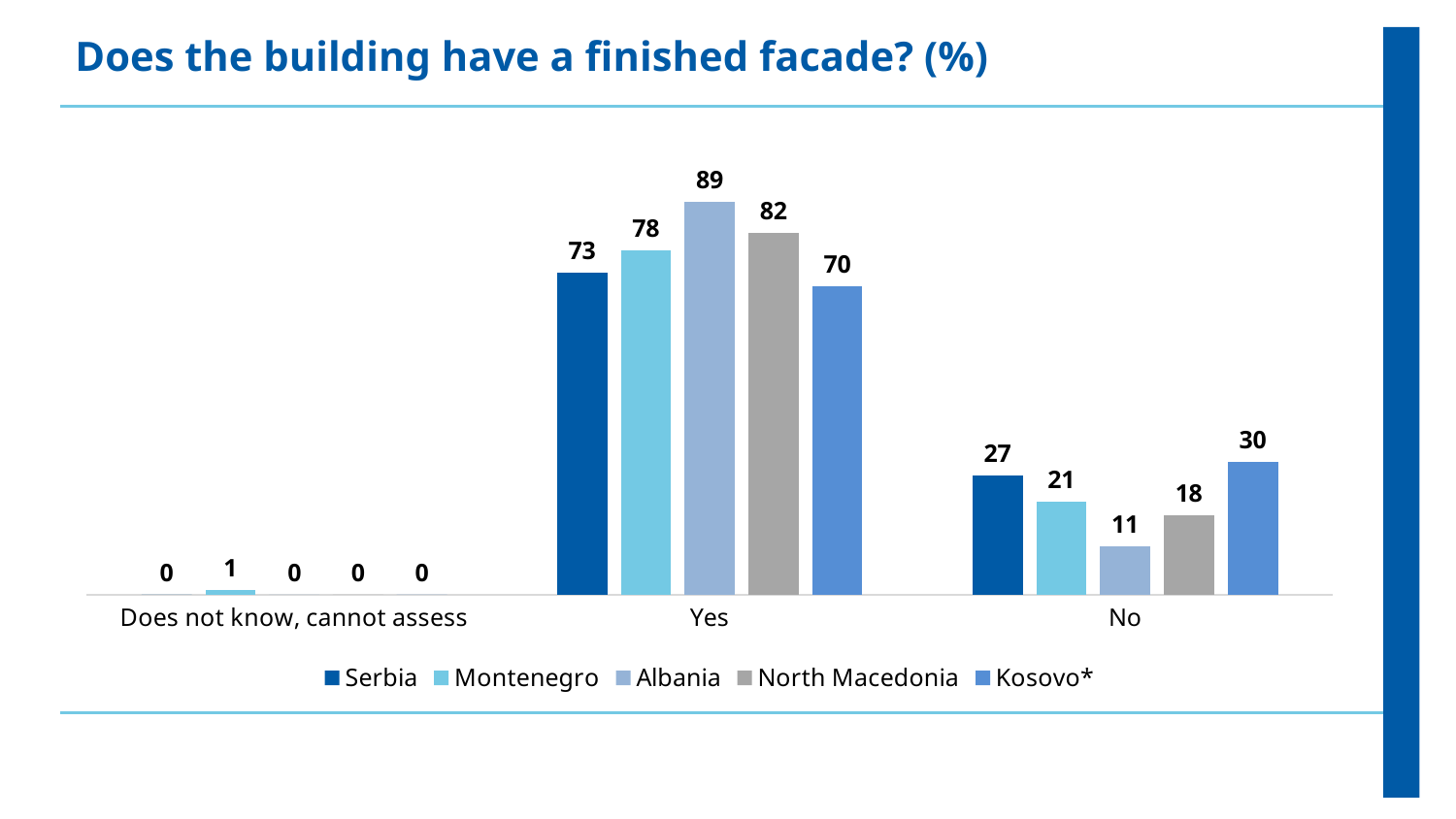
What is the difference between Kosovo* and Albania in the "No" category? 19 Which series has the lowest value in the "No" category? Albania What is the value for Montenegro in the "Does not know, cannot assess" category? 1 Which series has the highest value in the "Yes" category? Albania What is the value for Kosovo* in the "No" category? 30 What is the difference between North Macedonia and Serbia in the "Yes" category? 9 How many categories are shown on the x axis? 3 How many series does the legend list? 5 Which is larger in the "No" category: Serbia or Montenegro? Serbia What is the value for Albania in the "Yes" category? 89 What is the title of the chart? Does the building have a finished facade? (%) What kind of chart is shown on the slide? Bar chart